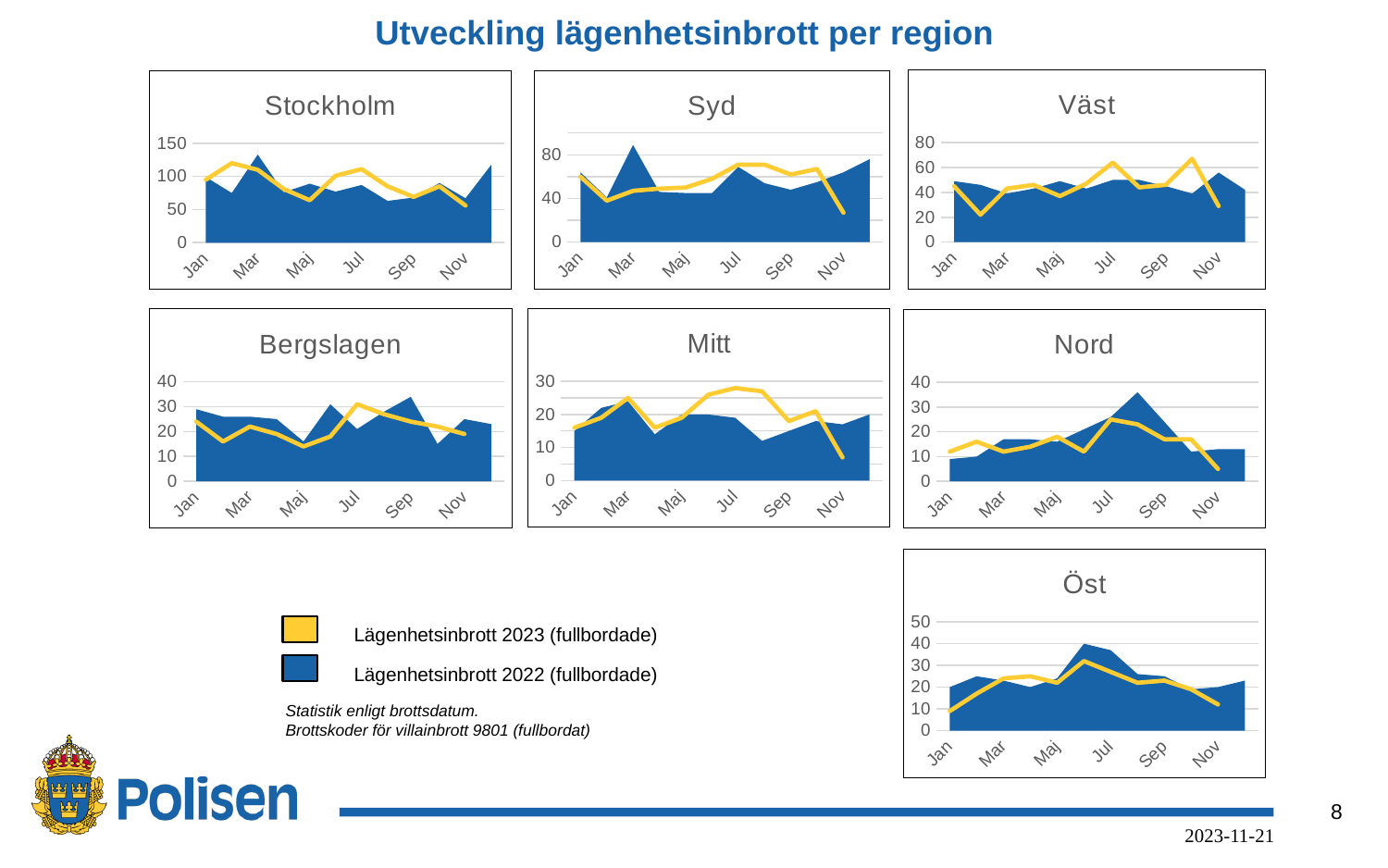
Which colour represents Lägenhetsinbrott 2023 (fullbordade) in the legend? yellow In the Öst chart, is the 2022 value for Jul greater or less than 30? greater In the Bergslagen chart, is the 2023 value for Maj greater or less than 20? less How many series does the legend list? 2 In the Stockholm chart, is the 2022 value for Mar greater or less than 100? greater What kind of chart is used for the yellow 2023 series in each region chart? line chart How many region charts are shown on the slide? 7 In the Stockholm chart, which month has the highest 2022 value? Mar